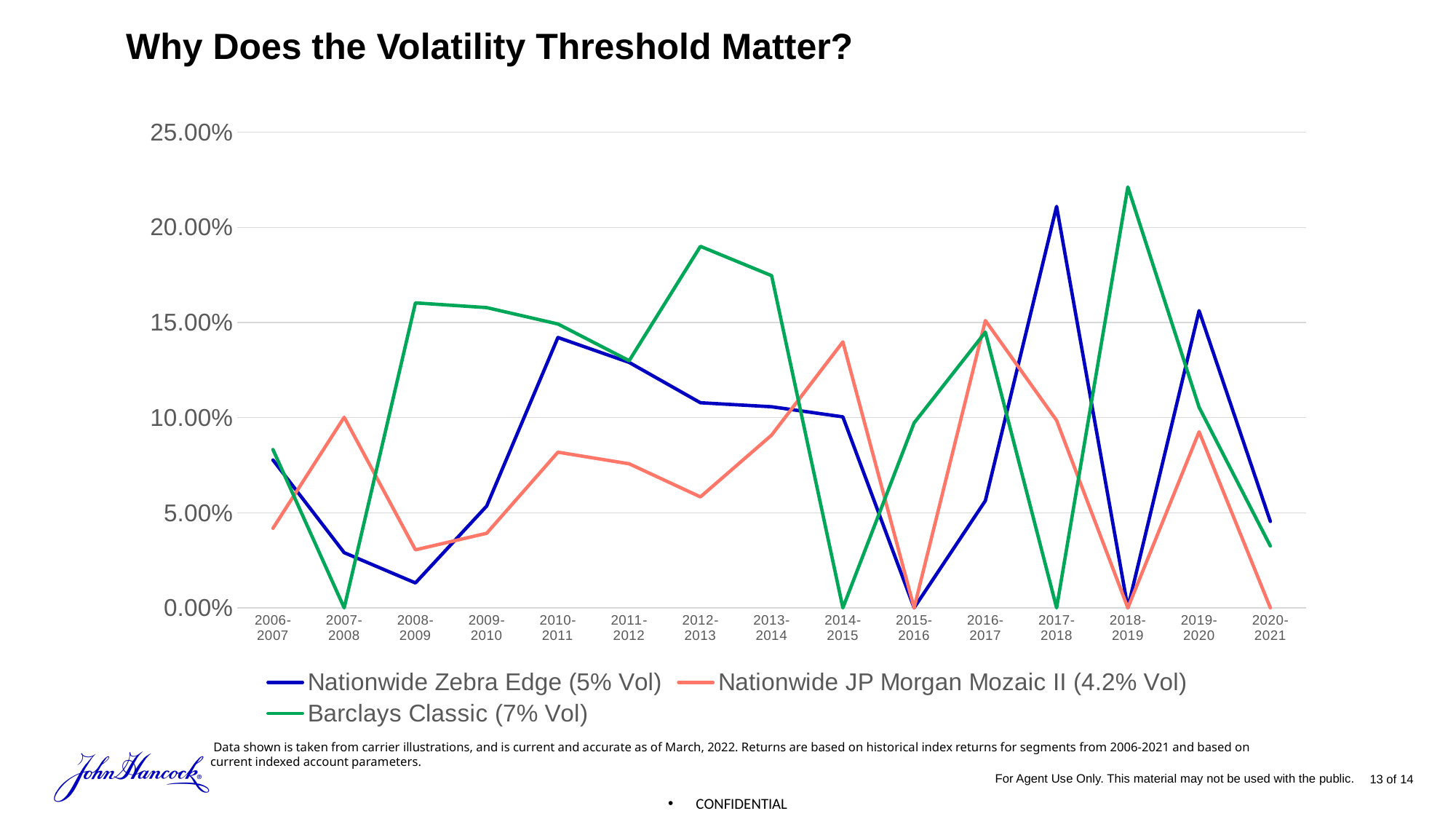
Is the value for Nationwide Zebra Edge (5% Vol) in 2008-2009 greater or less than 5.00%? less In 2012-2013, which is larger: Barclays Classic (7% Vol) or Nationwide JP Morgan Mozaic II (4.2% Vol)? Barclays Classic (7% Vol) In which period is Nationwide Zebra Edge (5% Vol) highest? 2017-2018 What is the value for Nationwide Zebra Edge (5% Vol) in 2015-2016? 0.00% In which period is Barclays Classic (7% Vol) highest? 2018-2019 What is the value for Nationwide JP Morgan Mozaic II (4.2% Vol) in 2020-2021? 0.00% What is the value for Barclays Classic (7% Vol) in 2007-2008? 0.00% How many time periods are shown along the x axis? 15 What kind of chart is shown on the slide? Line chart Is the value for Barclays Classic (7% Vol) in 2018-2019 greater or less than 20.00%? greater How many series does the legend list? 3 What is the title of the slide containing the chart? Why Does the Volatility Threshold Matter?